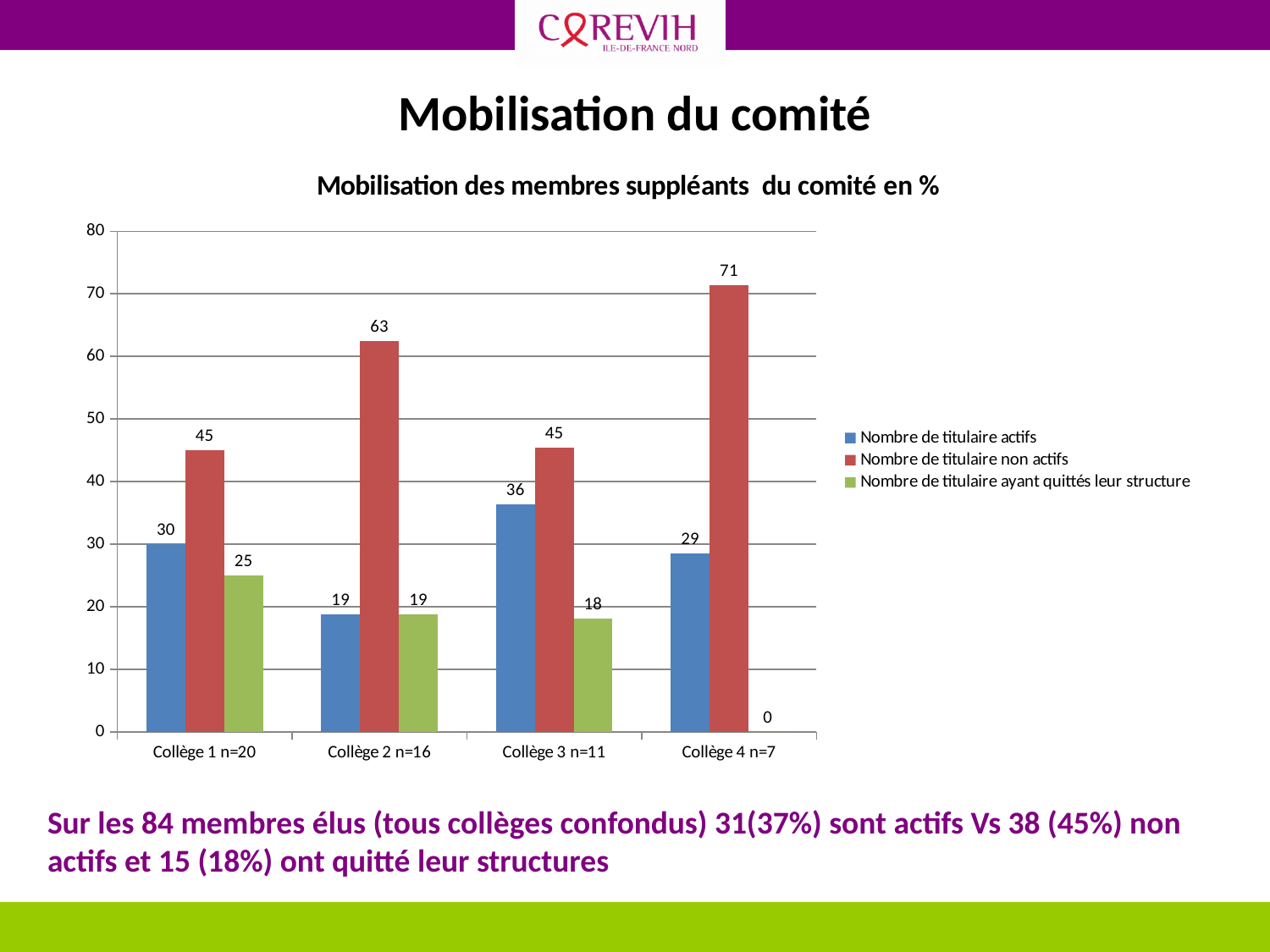
Which category has the lowest value for 'Nombre de titulaire ayant quittés leur structure'? Collège 4 n=7 What is the value for 'Nombre de titulaire ayant quittés leur structure' for Collège 4 n=7? 0 How many series does the legend list? 3 Which category has the highest value for 'Nombre de titulaire non actifs'? Collège 4 n=7 What is the value for 'Nombre de titulaire actifs' for Collège 3 n=11? 36 What is the title of the chart? Mobilisation des membres suppléants du comité en % How many categories are shown on the x axis? 4 What kind of chart is shown on the slide? bar chart What is the value for 'Nombre de titulaire non actifs' for Collège 2 n=16? 63 What is the difference between 'Nombre de titulaire non actifs' and 'Nombre de titulaire actifs' for Collège 4 n=7? 42 Is the value for 'Nombre de titulaire non actifs' for Collège 2 n=16 greater or less than 60? greater For Collège 1 n=20, which is larger: 'Nombre de titulaire actifs' or 'Nombre de titulaire ayant quittés leur structure'? Nombre de titulaire actifs